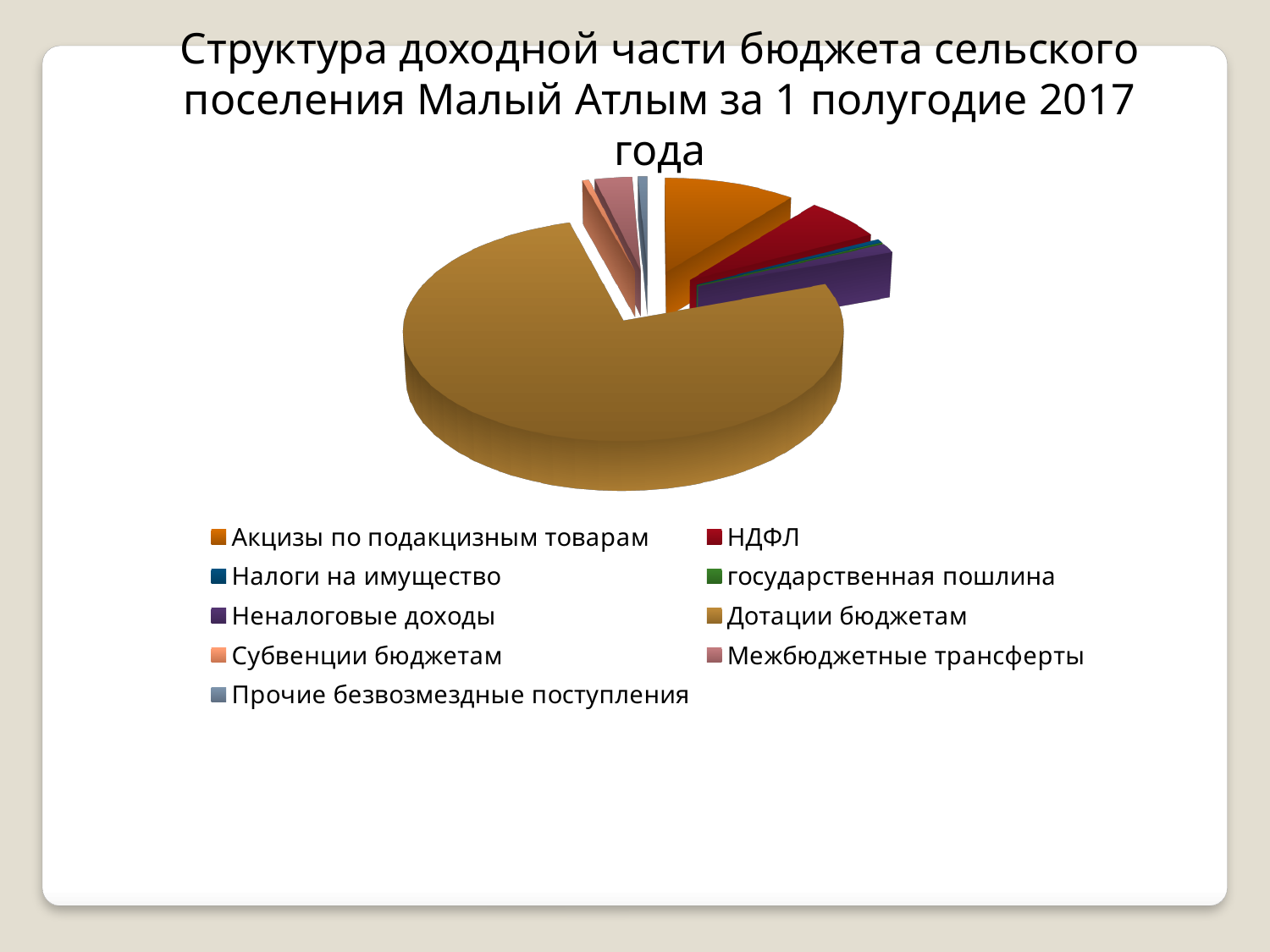
Which category is shown in the dark red colour in the legend? НДФЛ What kind of chart is shown on the slide? pie chart How many categories does the legend of the pie chart list? 9 Does the slice for Дотации бюджетам take up more or less than half of the pie? more Which slice is larger: Дотации бюджетам or Акцизы по подакцизным товарам? Дотации бюджетам What is the title of the chart on the slide? Структура доходной части бюджета сельского поселения Малый Атлым за 1 полугодие 2017 года Which slice is larger: Дотации бюджетам or Неналоговые доходы? Дотации бюджетам Which category has the largest slice of the pie chart? Дотации бюджетам Which slice is larger: НДФЛ or Дотации бюджетам? Дотации бюджетам